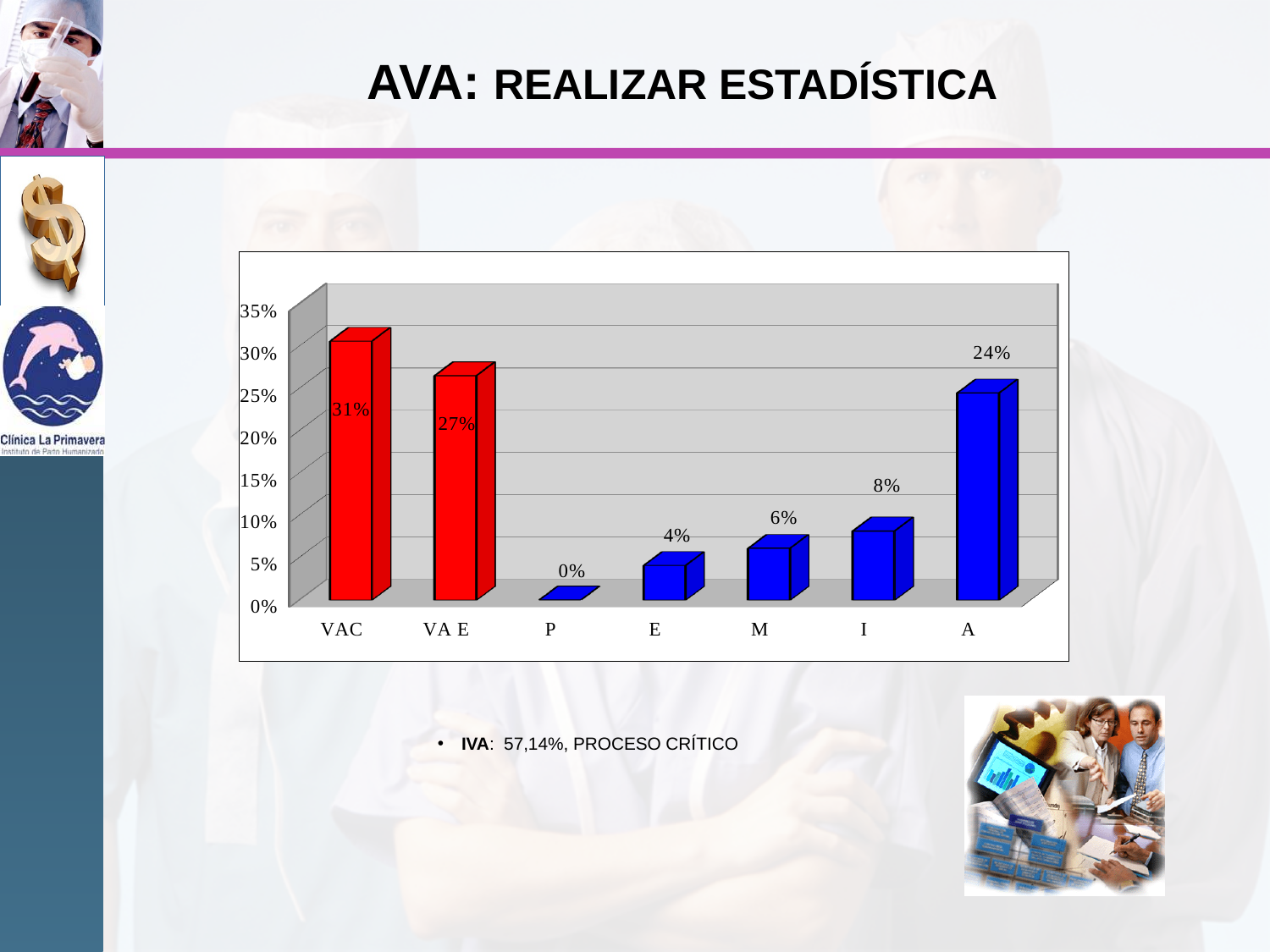
What is the value for VAC? 31% Which category has the lowest value? P What is the value for A? 24% Which is larger, the value for M or the value for E? M Which category has the highest value? VAC What colour are the bars for VAC and VA E? red What kind of chart is shown on the slide? bar chart What is the value for I? 8% How many categories are shown on the x axis? 7 What is the difference between the values for A and I? 16% What is the value for VA E? 27% What is the difference between the values for VAC and VA E? 4%